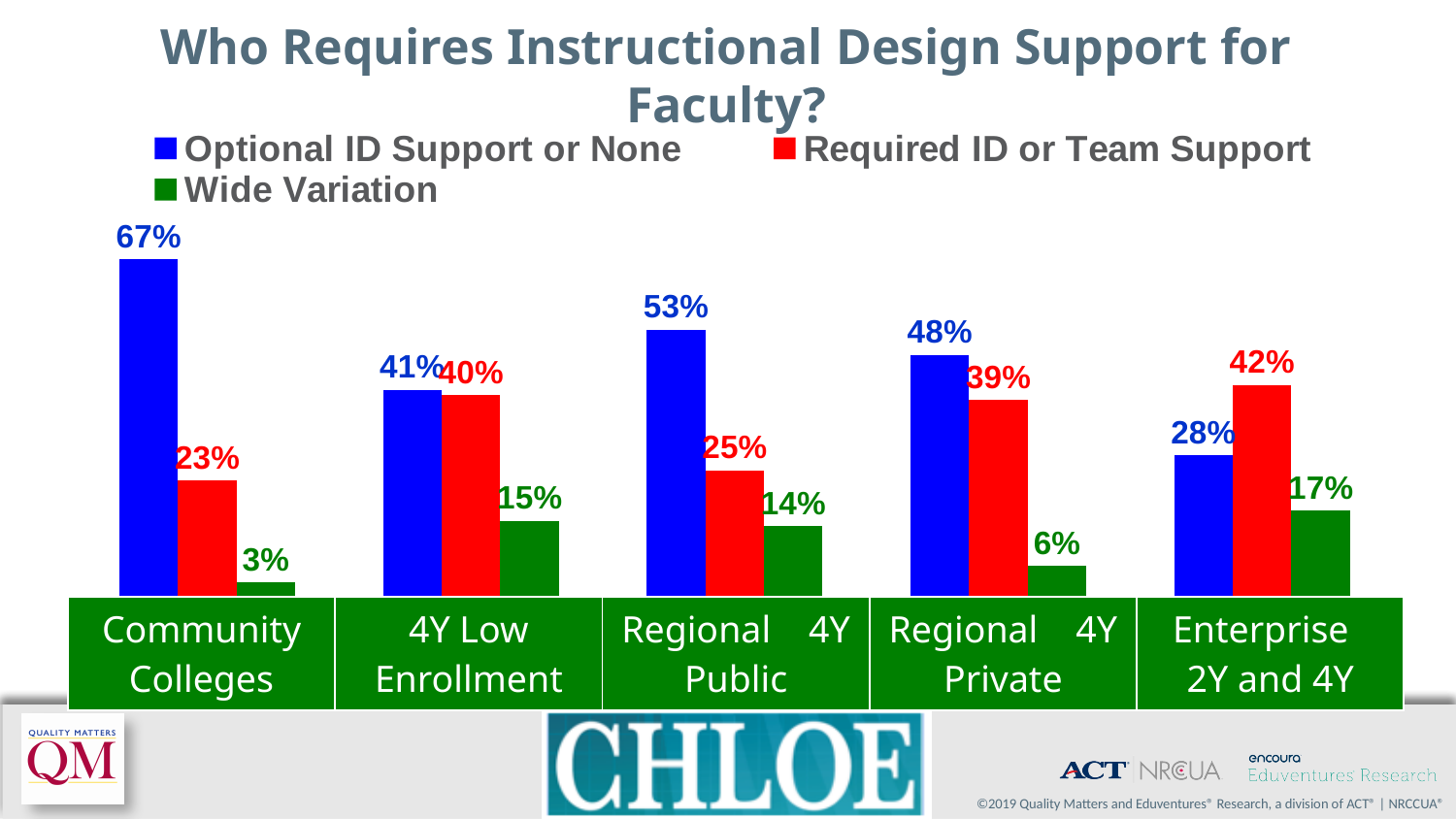
Which category has the highest value for Required ID or Team Support? Enterprise 2Y and 4Y What kind of chart is shown on the slide? Bar chart What is the value for Optional ID Support or None at Community Colleges? 67% Which category has the lowest value for Wide Variation? Community Colleges Which is larger at Enterprise 2Y and 4Y: Optional ID Support or None, or Required ID or Team Support? Required ID or Team Support What is the difference between Optional ID Support or None and Required ID or Team Support at Regional 4Y Public? 28% How many series does the legend list? 3 How many categories are shown on the x axis? 5 What is the value for Required ID or Team Support at Enterprise 2Y and 4Y? 42% What is the value for Wide Variation at Regional 4Y Private? 6% Which category has the highest value for Optional ID Support or None? Community Colleges What colour represents the Wide Variation series? Green